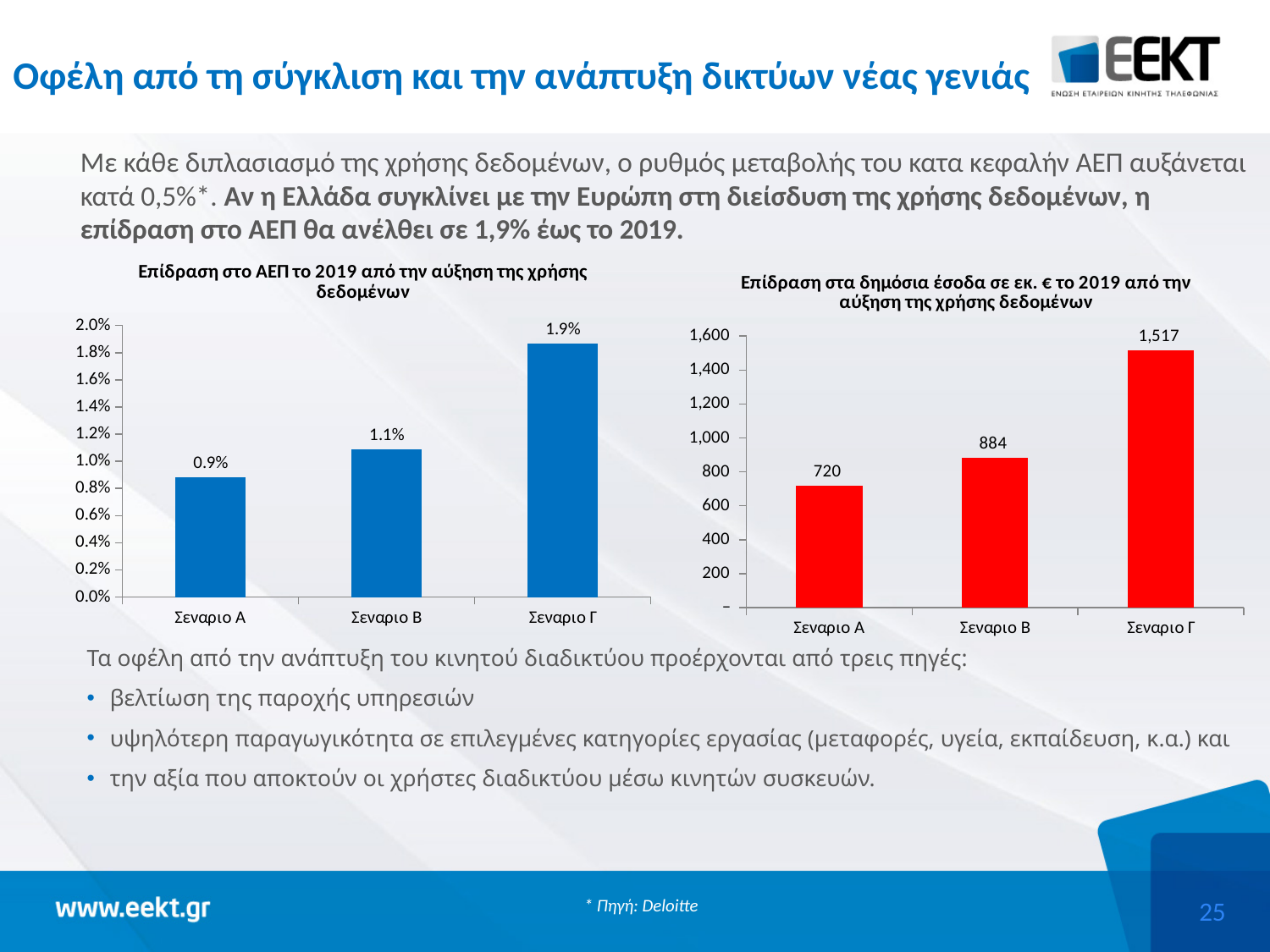
In the right chart (Επίδραση στα δημόσια έσοδα), which scenario has the lowest value? Σεναριο Α In the right chart (Επίδραση στα δημόσια έσοδα), do the values rise or fall from Σεναριο Α to Σεναριο Γ? Rise In the left chart (Επίδραση στο ΑΕΠ το 2019), what is the value for Σεναριο Α? 0.9% In the left chart (Επίδραση στο ΑΕΠ το 2019), what is the difference between Σεναριο Γ and Σεναριο Β? 0.8% In the right chart (Επίδραση στα δημόσια έσοδα), what is the value for Σεναριο Γ? 1,517 In the left chart (Επίδραση στο ΑΕΠ το 2019), which scenario has the highest value? Σεναριο Γ In the left chart (Επίδραση στο ΑΕΠ το 2019), what is the value for Σεναριο Γ? 1.9% What type of chart is the right chart (Επίδραση στα δημόσια έσοδα)? Bar chart How many scenarios are shown in the left chart (Επίδραση στο ΑΕΠ το 2019)? 3 In the right chart (Επίδραση στα δημόσια έσοδα), what is the difference between Σεναριο Γ and Σεναριο Α? 797 In the right chart (Επίδραση στα δημόσια έσοδα), what is the value for Σεναριο Β? 884 In the right chart (Επίδραση στα δημόσια έσοδα), which is larger, Σεναριο Α or Σεναριο Β? Σεναριο Β